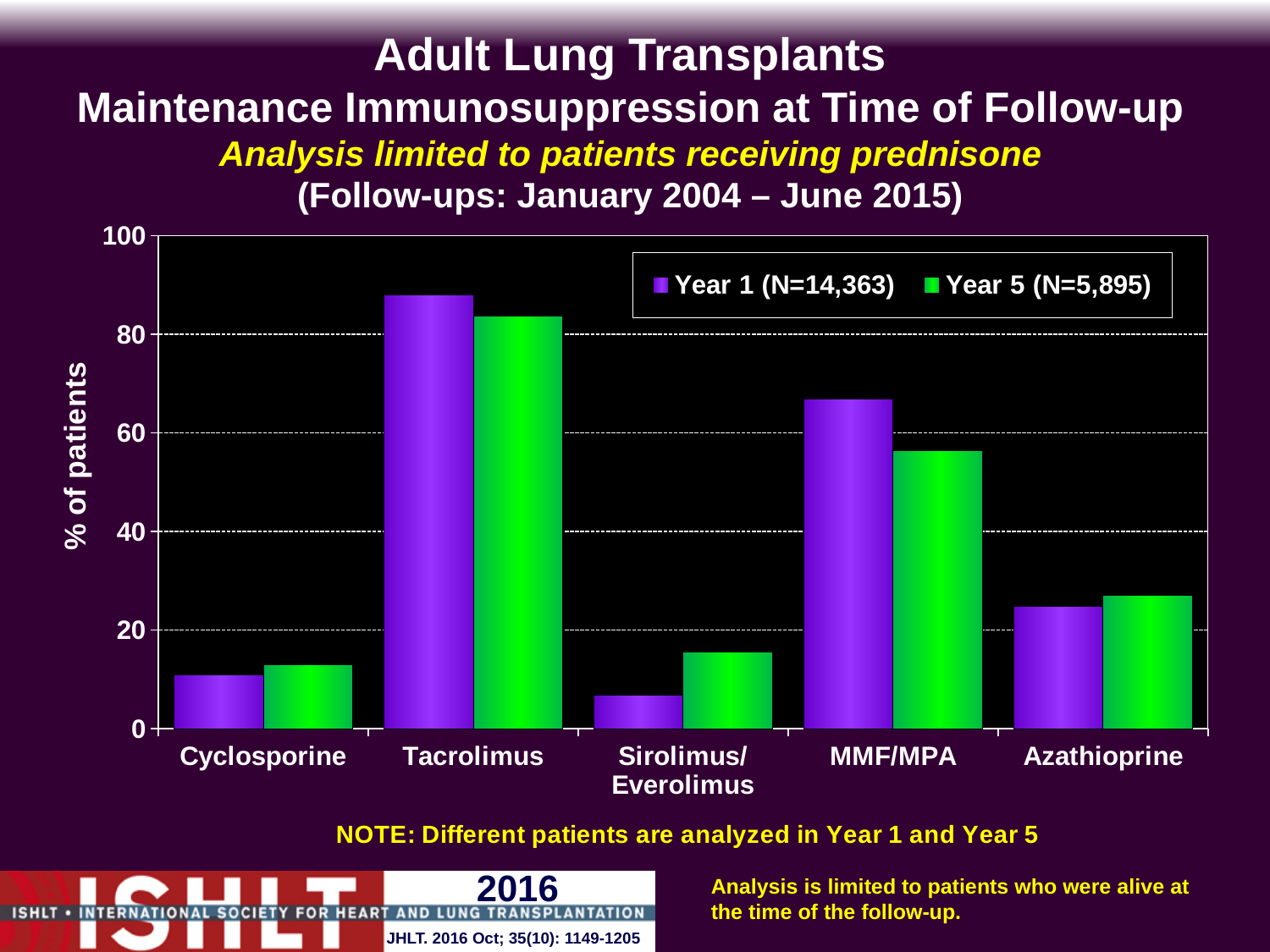
How many drug categories are shown on the x axis? 5 Is the Year 5 value for MMF/MPA greater or less than 60? less For MMF/MPA, which is larger: the Year 1 value or the Year 5 value? Year 1 Which drug category has the lowest Year 1 value? Sirolimus/Everolimus What is the N shown in the legend for Year 1? 14,363 What kind of chart is shown on the slide? bar chart Is the Year 1 value for Cyclosporine greater or less than 20? less How many series does the legend list? 2 Which drug category has the highest Year 5 value? Tacrolimus Is the Year 1 value for Tacrolimus greater or less than 80? greater Which drug category has the highest Year 1 value? Tacrolimus For Sirolimus/Everolimus, which is larger: the Year 1 value or the Year 5 value? Year 5